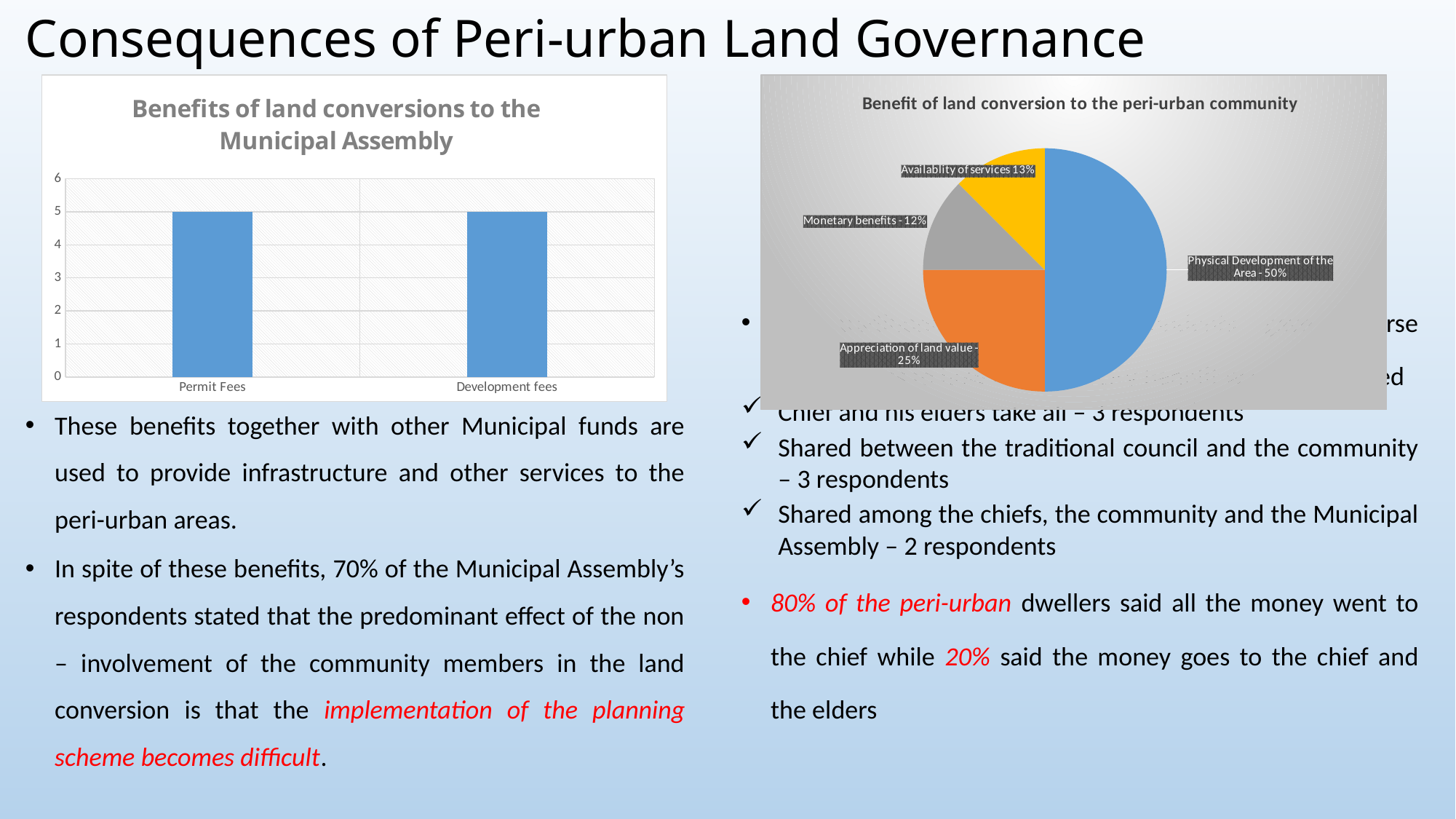
In the 'Benefits of land conversions to the Municipal Assembly' chart, is the value for Permit Fees greater or less than 3? greater In the 'Benefit of land conversion to the peri-urban community' pie chart, which slice is the largest? Physical Development of the Area How many categories are shown in the 'Benefits of land conversions to the Municipal Assembly' chart? 2 In the 'Benefit of land conversion to the peri-urban community' pie chart, what is the difference between the Physical Development of the Area share and the Appreciation of land value share? 25% In the 'Benefits of land conversions to the Municipal Assembly' chart, what is the value for Development fees? 5 In the 'Benefit of land conversion to the peri-urban community' pie chart, what share is Physical Development of the Area? 50% In the 'Benefit of land conversion to the peri-urban community' pie chart, what share is Availability of services? 13% What kind of chart is the 'Benefits of land conversions to the Municipal Assembly' chart? bar chart What kind of chart is the 'Benefit of land conversion to the peri-urban community' chart? pie chart In the 'Benefits of land conversions to the Municipal Assembly' chart, what is the value for Permit Fees? 5 In the 'Benefit of land conversion to the peri-urban community' pie chart, what share is Appreciation of land value? 25%